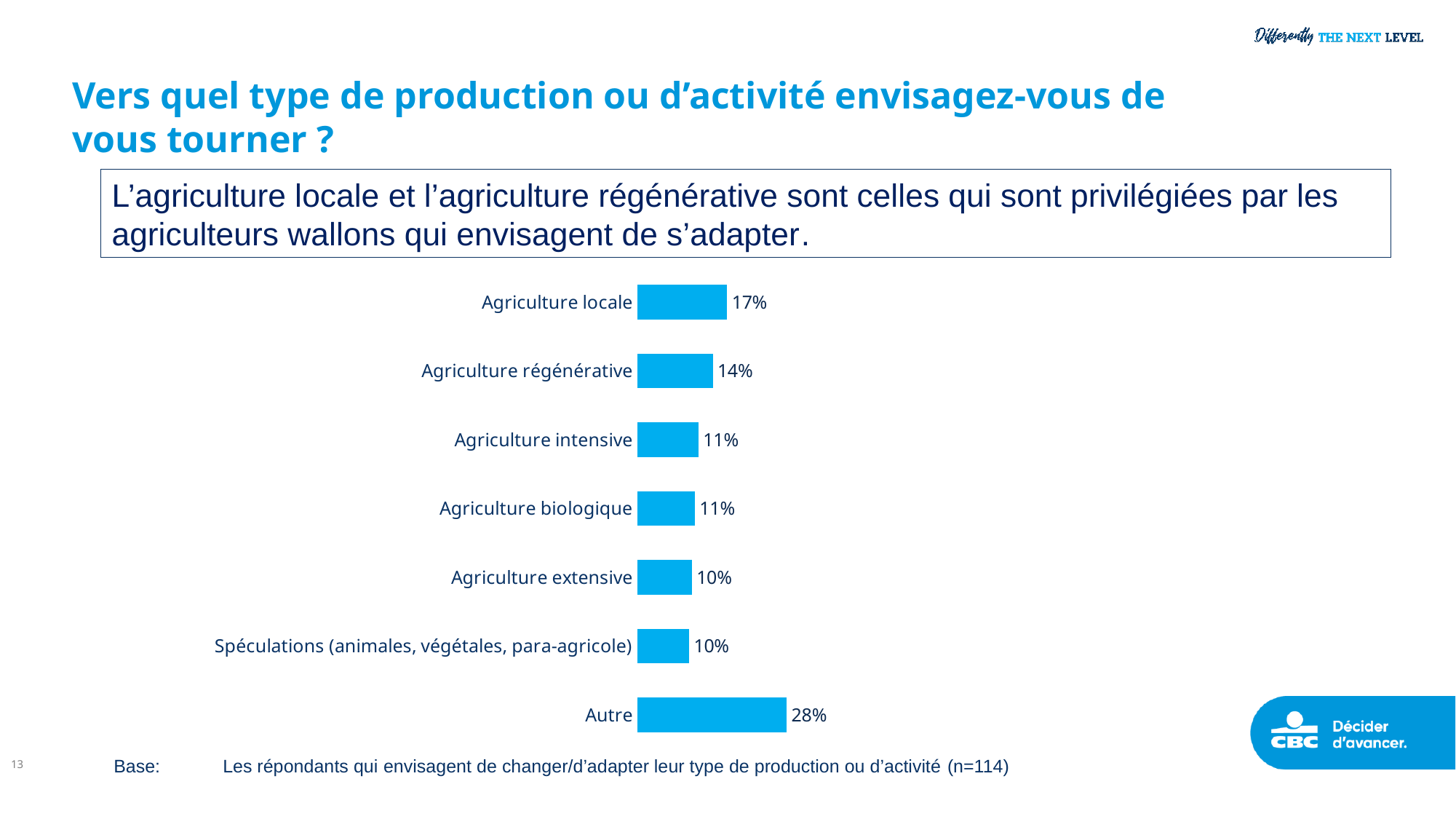
What is the value for Agriculture extensive? 10% What is the sample size (n) given in the base note below the chart? n=114 What is the value for Agriculture régénérative? 14% Which of the named agriculture types (excluding Autre) has the highest value? Agriculture locale What is the difference between Agriculture locale and Agriculture régénérative? 3% What kind of chart is shown on the slide? Bar chart What is the difference between Autre and Agriculture locale? 11% What is the value for Autre? 28% How many categories are shown in the chart? 7 What is the value for Agriculture locale? 17% Which category has the highest value? Autre Which is larger, Agriculture régénérative or Agriculture intensive? Agriculture régénérative